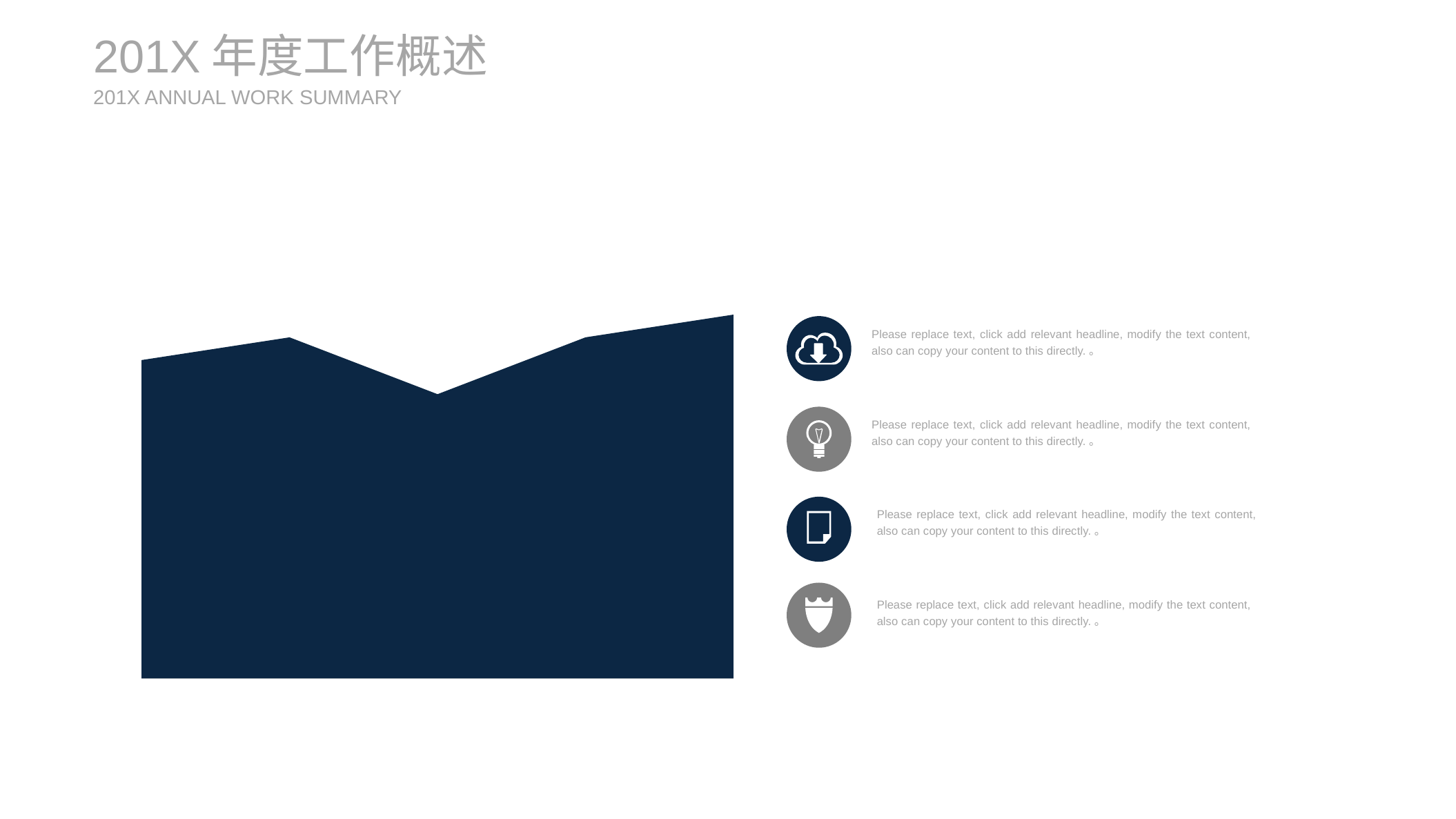
Does the area chart rise or fall from its second point to its third point? fall What colour is the area chart filled with? dark navy blue What kind of chart is shown on the slide? area chart Which point of the area chart is the lowest: the first, the middle, or the last? the middle How many data points does the area chart plot? 5 Which point of the area chart is the highest: the first, the middle, or the last? the last Does the area chart rise or fall from its middle point to its last point? rise Does the area chart display any axis labels or data labels? No Which is higher in the area chart, the leftmost point or the rightmost point? the rightmost point